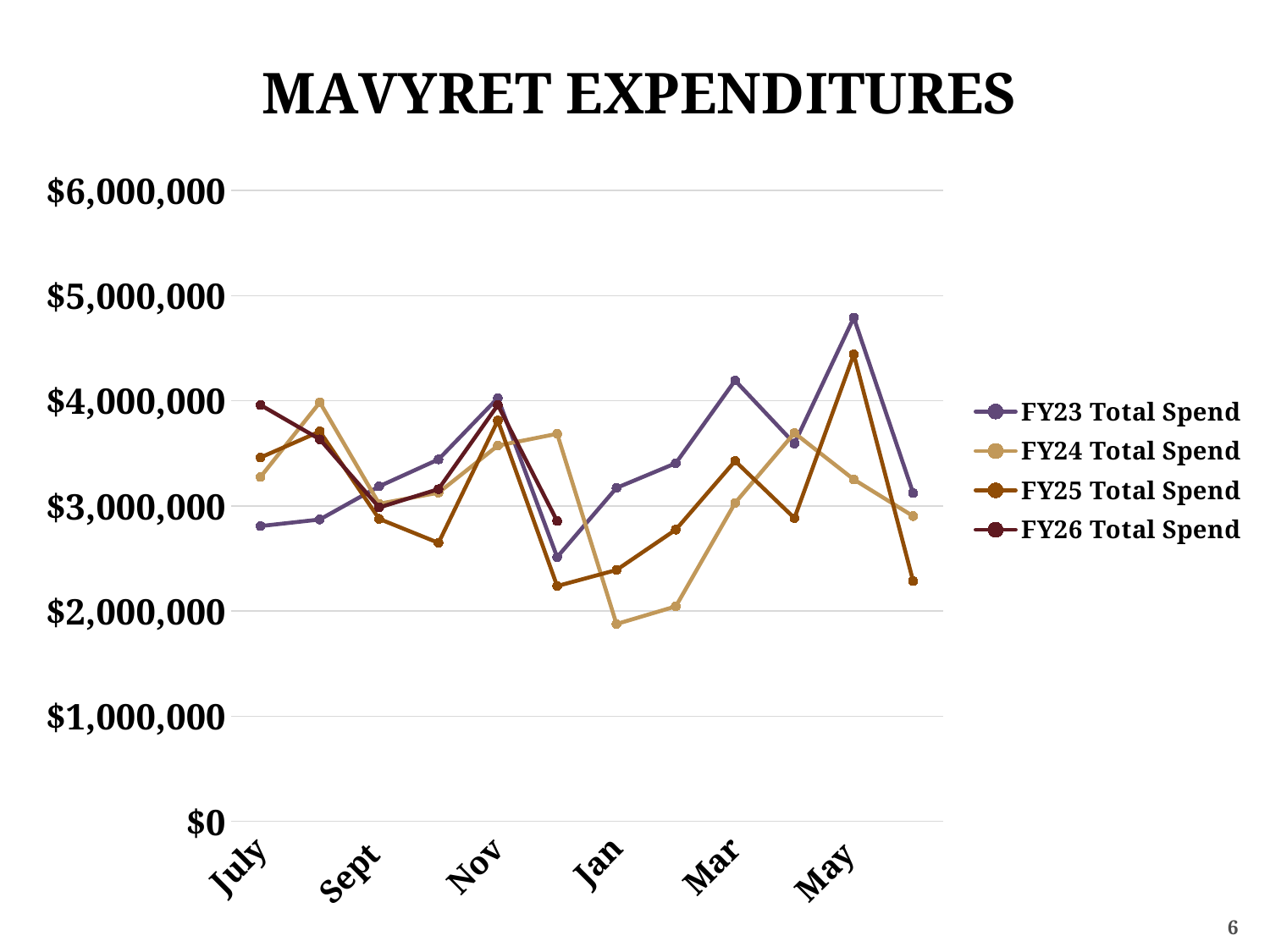
Which series has the highest value in May? FY23 Total Spend Is the FY23 Total Spend value for May greater or less than $4,000,000? greater What is the title of the chart? MAVYRET EXPENDITURES What kind of chart is shown on the slide? Line chart Which series has the lowest value in Jan? FY24 Total Spend Is the FY25 Total Spend value for Nov greater or less than $3,000,000? greater How many series does the legend list? 4 Is the FY23 Total Spend value for July greater or less than $3,000,000? less Does the FY23 Total Spend line rise or fall from July to Nov? Rise In July, which is larger: FY26 Total Spend or FY23 Total Spend? FY26 Total Spend Which series are listed in the legend? FY23 Total Spend, FY24 Total Spend, FY25 Total Spend, FY26 Total Spend